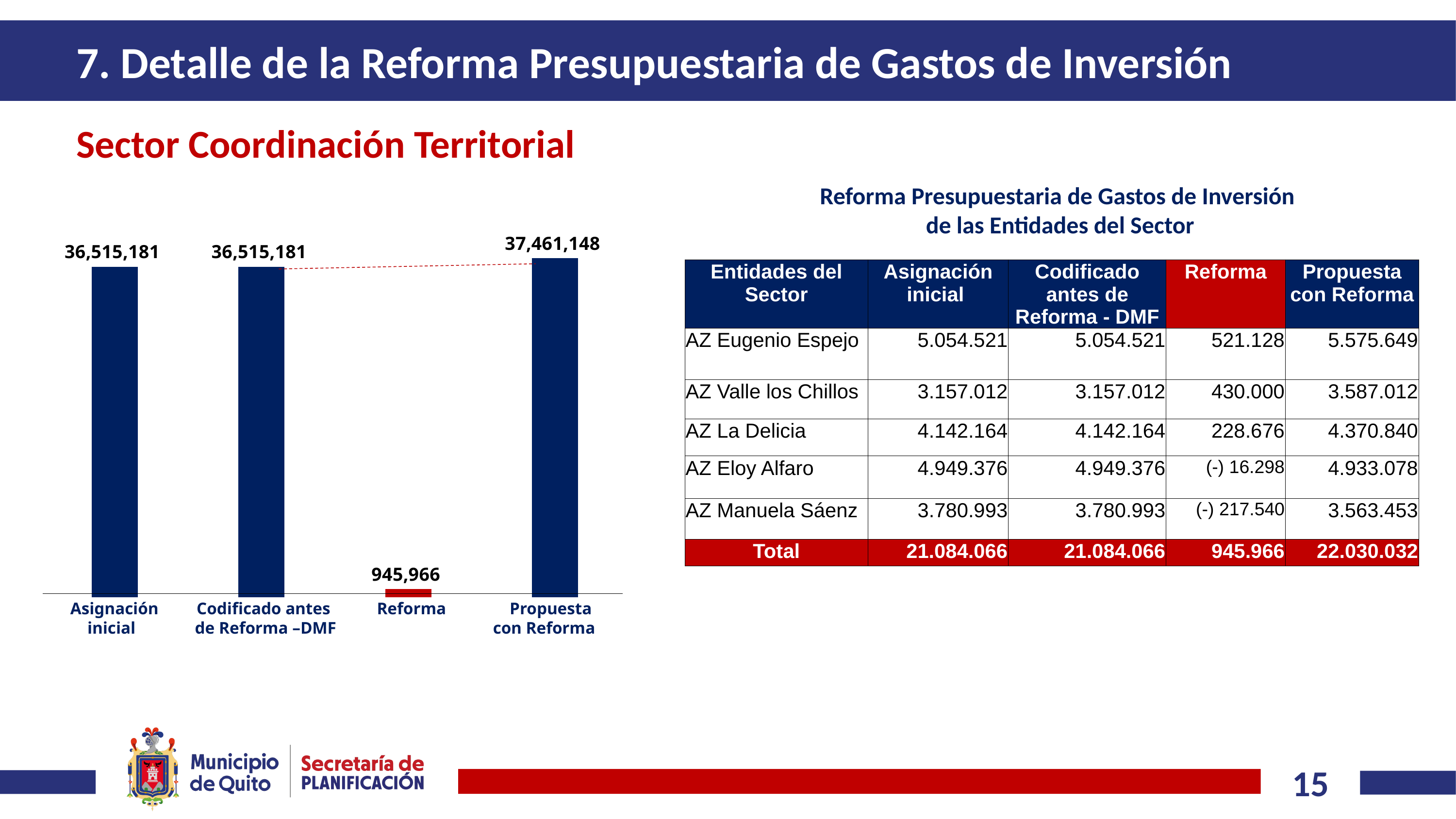
What is the difference between the Propuesta con Reforma value and the Asignación inicial value? 945,967 Which category has the lowest value in the chart? Reforma What is the value of the Reforma bar? 945,966 What is the heading shown above the chart on the slide? Sector Coordinación Territorial What type of chart is shown on the slide? bar chart How many bars are shown in the chart? 4 What is the value of the Propuesta con Reforma bar? 37,461,148 Which category has the highest value in the chart? Propuesta con Reforma What is the value of the Codificado antes de Reforma –DMF bar? 36,515,181 What is the value of the Asignación inicial bar? 36,515,181 What colour is the Reforma bar in the chart? red Which is larger, the Propuesta con Reforma bar or the Asignación inicial bar? Propuesta con Reforma